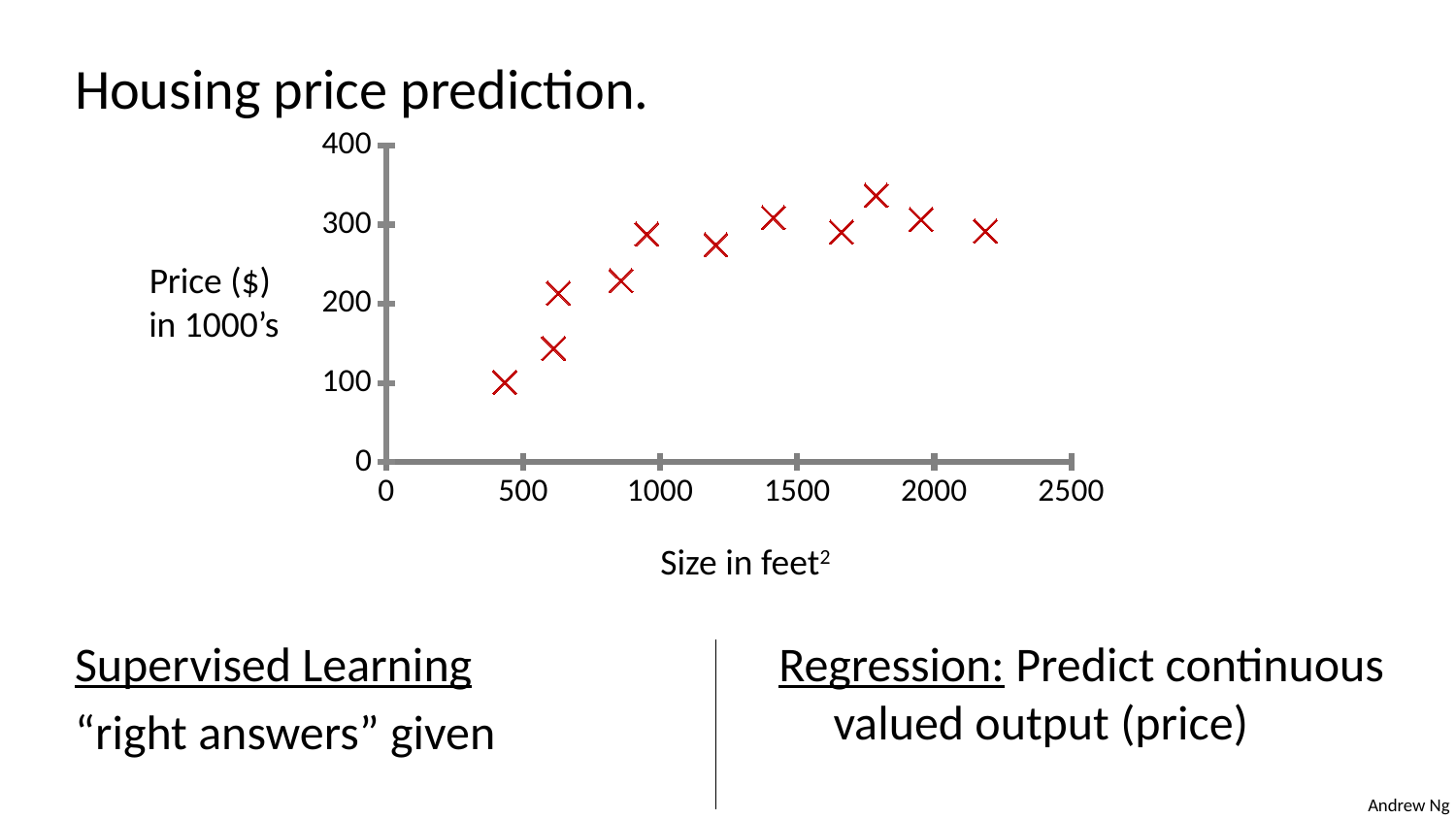
Is the price for the house of about 600 square feet (the lower of the two points near 600) greater or less than 200? less What kind of chart is shown on the slide? scatter plot Do prices generally rise or fall as house size increases from 0 to 1500 square feet? rise Is the price for the house of about 850 square feet greater or less than 200? greater Is the price for the house of about 1200 square feet greater or less than 300? less Which data point has the highest price: the one near 1800 square feet or the one near 1400 square feet? the one near 1800 square feet What is the title of the slide containing the chart? Housing price prediction. What is the label of the x axis? Size in feet² How many data points are plotted on the chart? 11